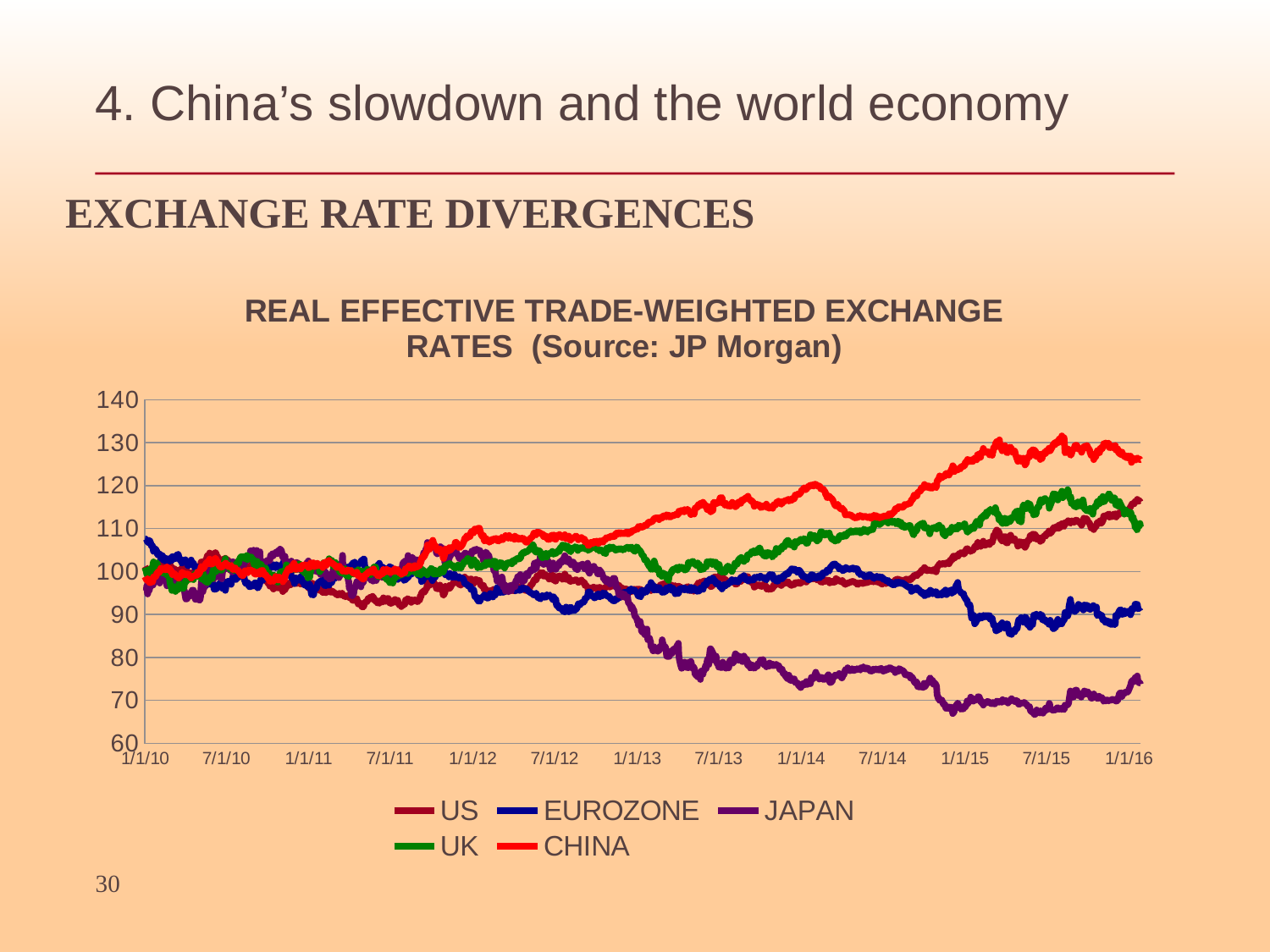
Is the value for JAPAN at 1/1/15 greater or less than 80? less At 1/1/16, which is larger, the value for CHINA or the value for EUROZONE? CHINA Is the value for CHINA at 1/1/16 greater or less than 120? greater Which series is plotted in red? CHINA Which series has the lowest value at 1/1/16? JAPAN How many series does the legend list? 5 Does the JAPAN series rise or fall between 1/1/13 and 1/1/15? fall Which series has the highest value at 1/1/16? CHINA What source is cited in the chart title? JP Morgan Is the value for JAPAN at 1/1/16 greater or less than 80? less What kind of chart is shown on the slide? line chart